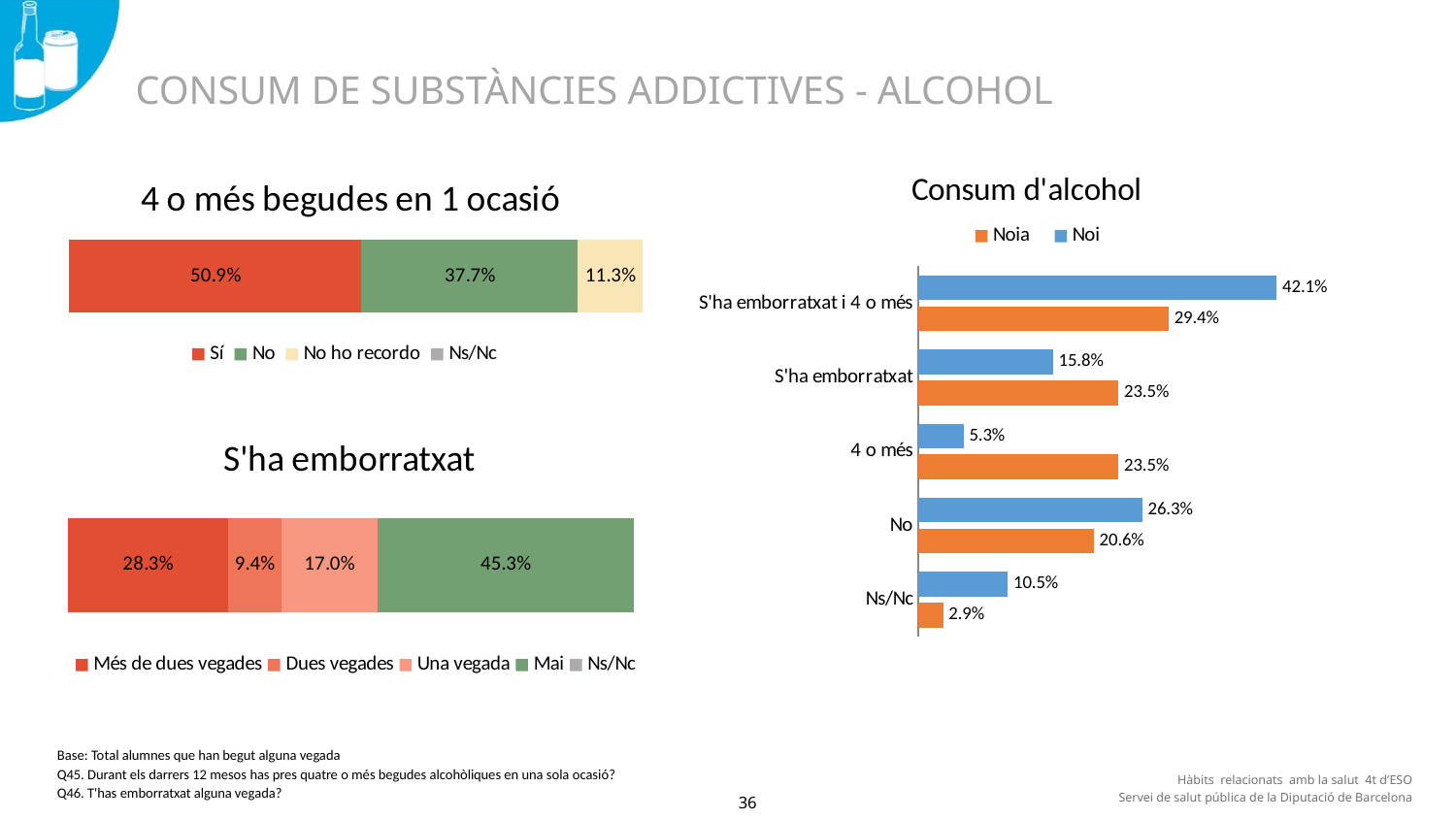
In the 'S'ha emborratxat' chart, what is the difference between 'Més de dues vegades' and 'Una vegada'? 11.3% In the 'S'ha emborratxat' chart, which labelled segment has the lowest value? Dues vegades In the 'Consum d'alcohol' chart, what is the difference between Noi and Noia for 'S'ha emborratxat i 4 o més'? 12.7% What kind of chart is 'Consum d'alcohol'? Bar chart In the 'S'ha emborratxat' chart, what is the value for 'Mai'? 45.3% In the 'Consum d'alcohol' chart, which is larger for 'No': Noia or Noi? Noi In the '4 o més begudes en 1 ocasió' chart, what is the value for 'Sí'? 50.9% In the 'Consum d'alcohol' chart, what is the value for Noi in 'S'ha emborratxat i 4 o més'? 42.1% In the '4 o més begudes en 1 ocasió' chart, what is the value for 'No ho recordo'? 11.3% In the 'Consum d'alcohol' chart, which category has the lowest value for Noia? Ns/Nc How many series does the legend of the 'Consum d'alcohol' chart list? 2 In the 'Consum d'alcohol' chart, what is the value for Noia in '4 o més'? 23.5%